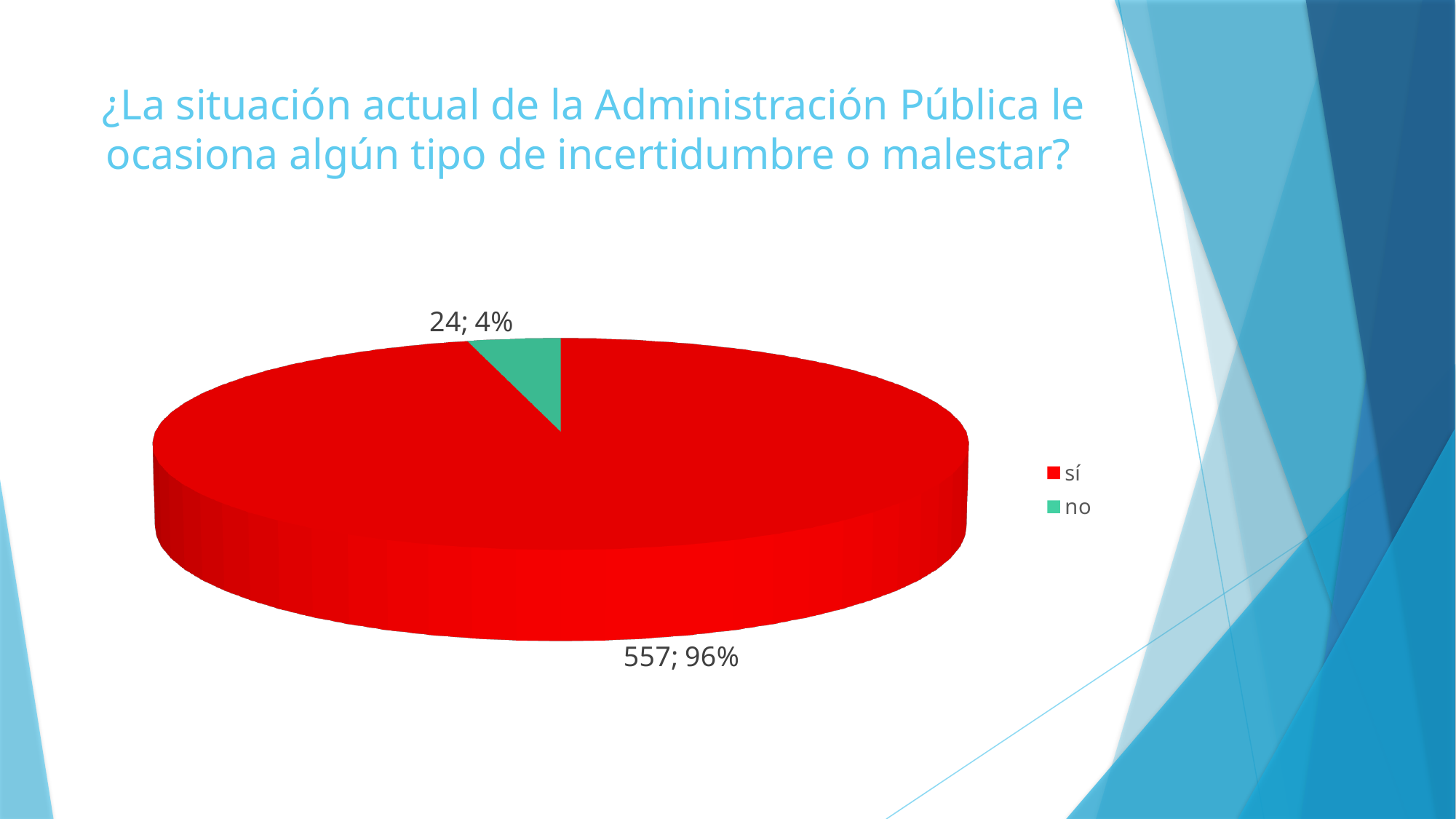
What is the total number of responses shown in the pie chart? 581 What is the difference between the number of "sí" and "no" responses? 533 What colour is the "no" slice? green Which is larger, the "sí" slice or the "no" slice? sí How many respondents answered "sí"? 557 What kind of chart is shown on the slide? pie chart How many respondents answered "no"? 24 What percentage of the pie does the "sí" slice represent? 96% How many categories does the pie chart have? 2 Which category has the smallest slice? no What percentage of the pie does the "no" slice represent? 4% Which category has the largest slice? sí